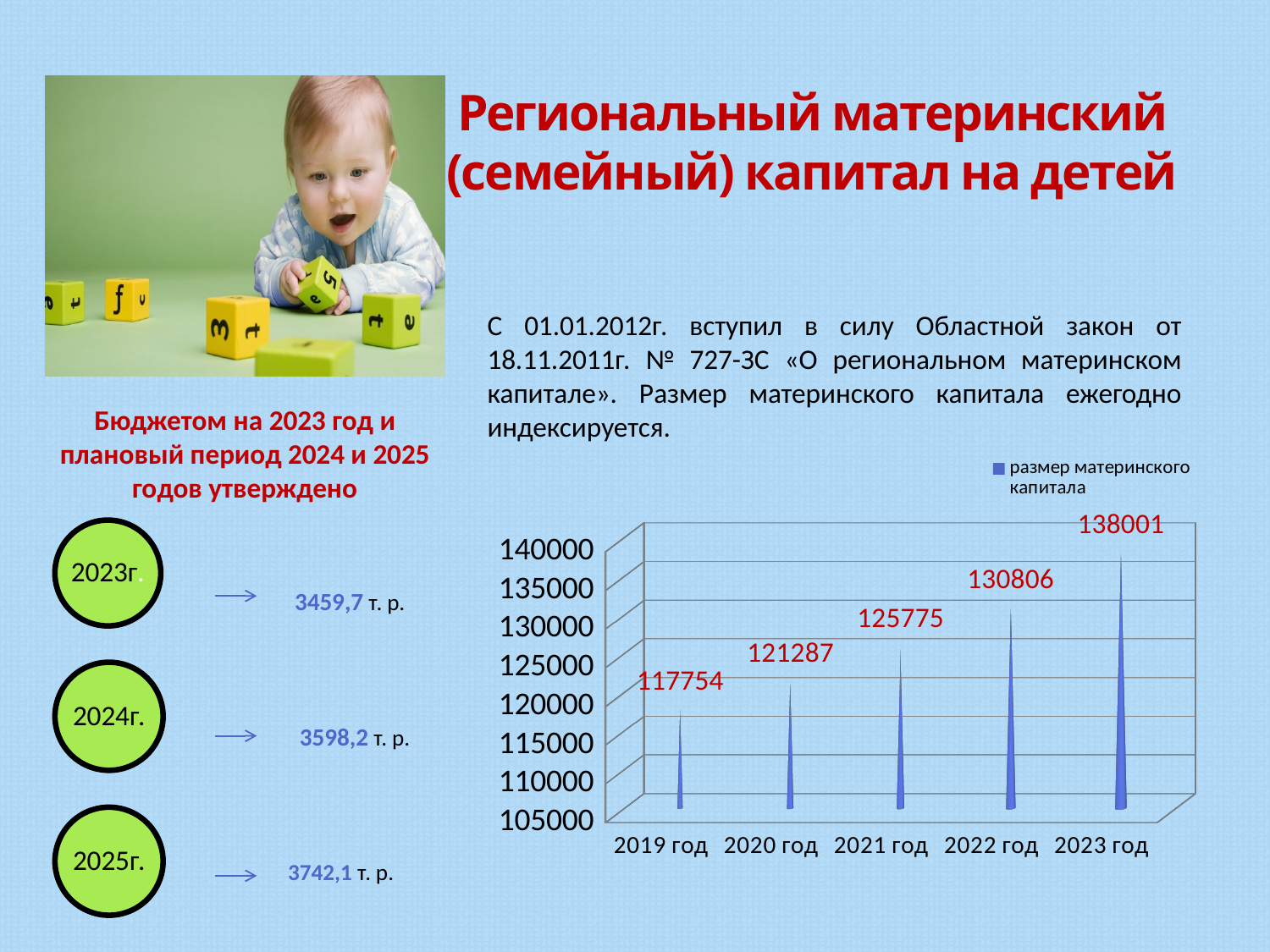
What is the value for 2021 год? 125775 How many years are shown on the x axis? 5 What is the value for 2019 год? 117754 Which year has the lowest value? 2019 год Is the value for 2022 год greater or less than 125000? greater Which is larger, the value for 2021 год or the value for 2020 год? 2021 год What series name does the legend show? размер материнского капитала What is the difference between the values for 2020 год and 2019 год? 3533 Do the values rise or fall from 2019 год to 2023 год? rise What is the difference between the values for 2023 год and 2022 год? 7195 Which year has the highest value? 2023 год What is the value for 2023 год? 138001